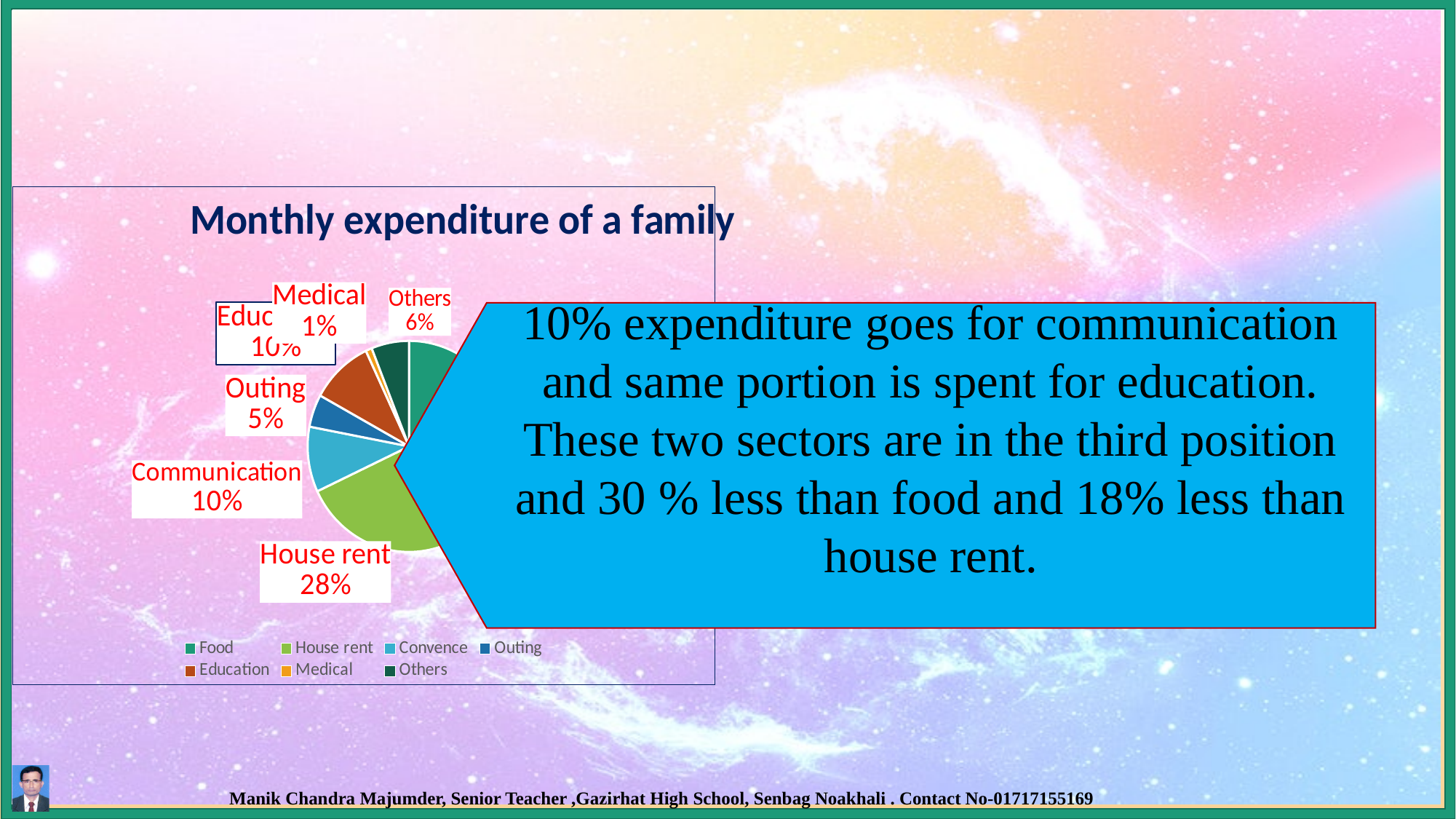
Which is larger, the share for Others or the share for Outing? Others How many categories does the legend list? 7 What percentage of monthly expenditure goes to Medical? 1% What is the difference between the Others share and the Medical share? 5% How much larger is the House rent share than the Communication share? 18% What is the title of the chart? Monthly expenditure of a family Which category has the smallest share of the pie? Medical What percentage of monthly expenditure goes to House rent? 28% What percentage of monthly expenditure goes to Others? 6% What percentage of monthly expenditure goes to Outing? 5% What percentage of monthly expenditure goes to Communication? 10% What kind of chart is shown on the slide? pie chart